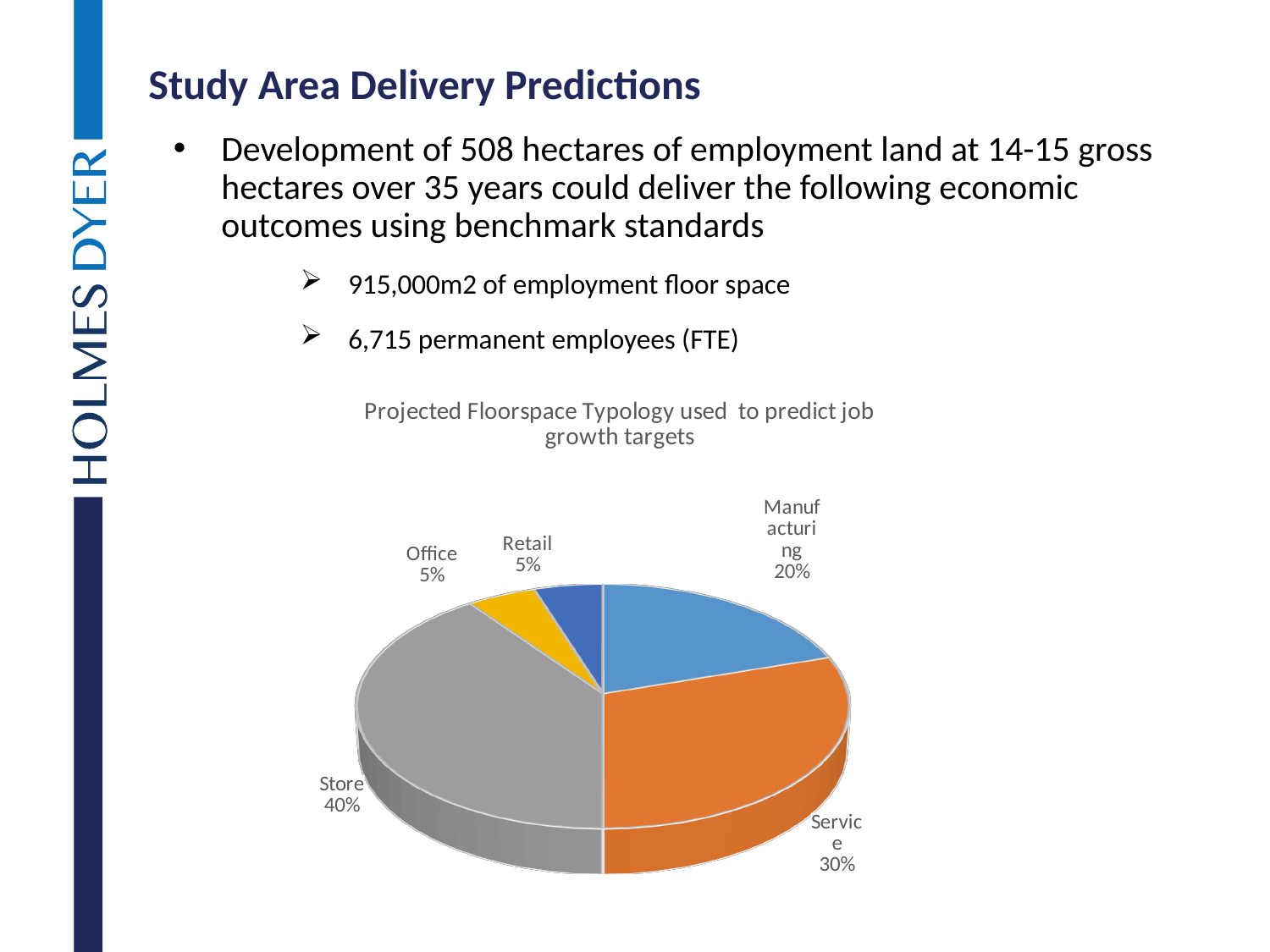
What colour is the Store slice in the pie chart? grey What percentage share does Manufacturing have in the pie chart? 20% What percentage share does Office have in the pie chart? 5% What percentage share does Service have in the pie chart? 30% What is the difference in percentage points between the Manufacturing and Retail shares? 15% Which category has the largest share of the pie chart? Store What percentage share does Store have in the pie chart? 40% How many categories are shown in the pie chart? 5 What kind of chart is shown on the slide? pie chart What is the title of the chart? Projected Floorspace Typology used to predict job growth targets What is the difference in percentage points between the Store and Service shares? 10% Which has a larger share, Manufacturing or Service? Service